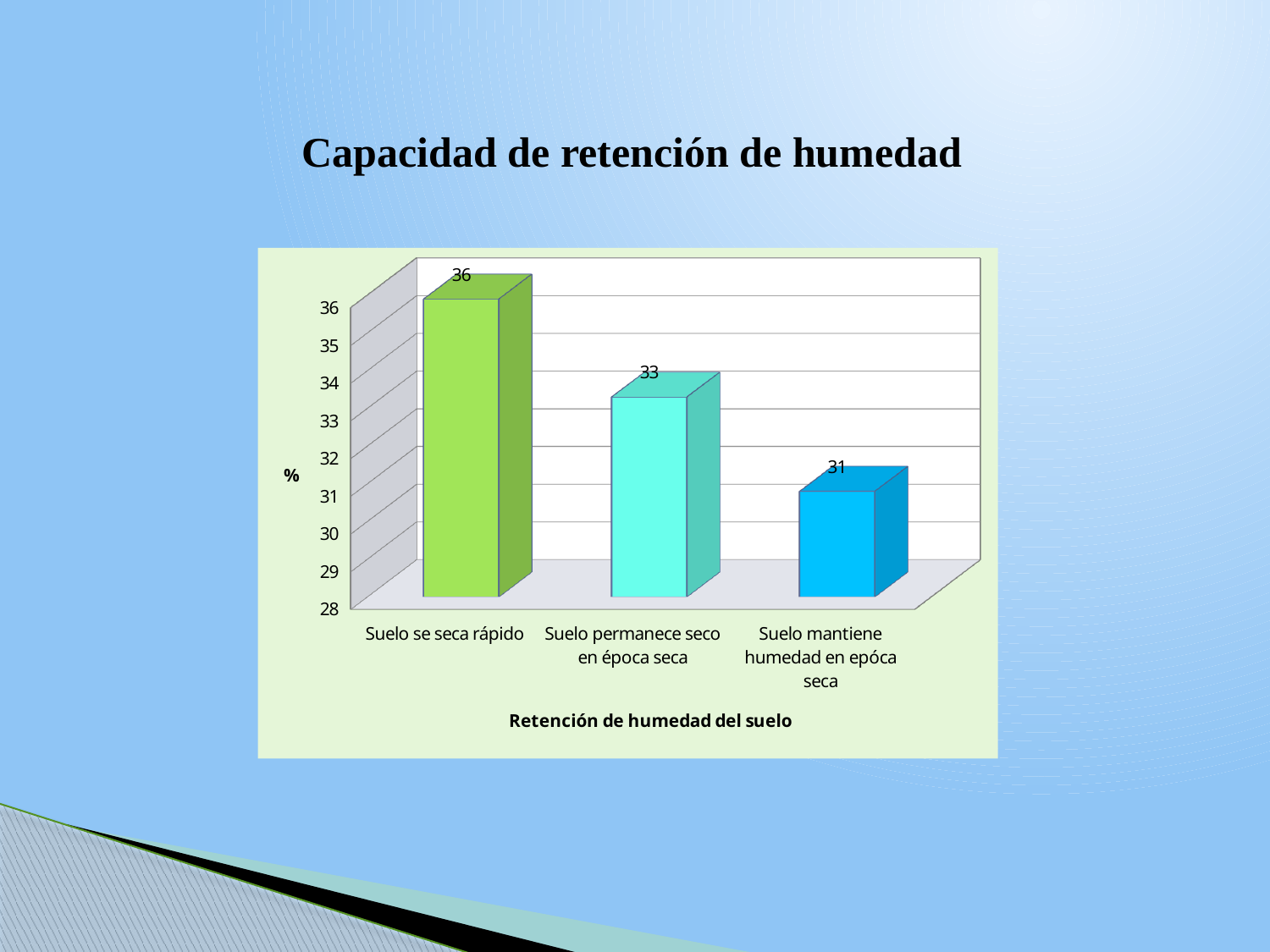
What is the value for "Suelo permanece seco en época seca"? 33 How many categories are shown on the x axis? 3 Which category has the highest value? Suelo se seca rápido Which is larger, the value for "Suelo se seca rápido" or for "Suelo permanece seco en época seca"? Suelo se seca rápido What is the value for "Suelo mantiene humedad en epóca seca"? 31 What is the difference between the values for "Suelo permanece seco en época seca" and "Suelo mantiene humedad en epóca seca"? 2 What kind of chart is shown on the slide? Bar chart What is the title of the x axis? Retención de humedad del suelo Do the values rise or fall from left to right along the x axis? Fall What is the value for "Suelo se seca rápido"? 36 What is the difference between the values for "Suelo se seca rápido" and "Suelo mantiene humedad en epóca seca"? 5 Which category has the lowest value? Suelo mantiene humedad en epóca seca